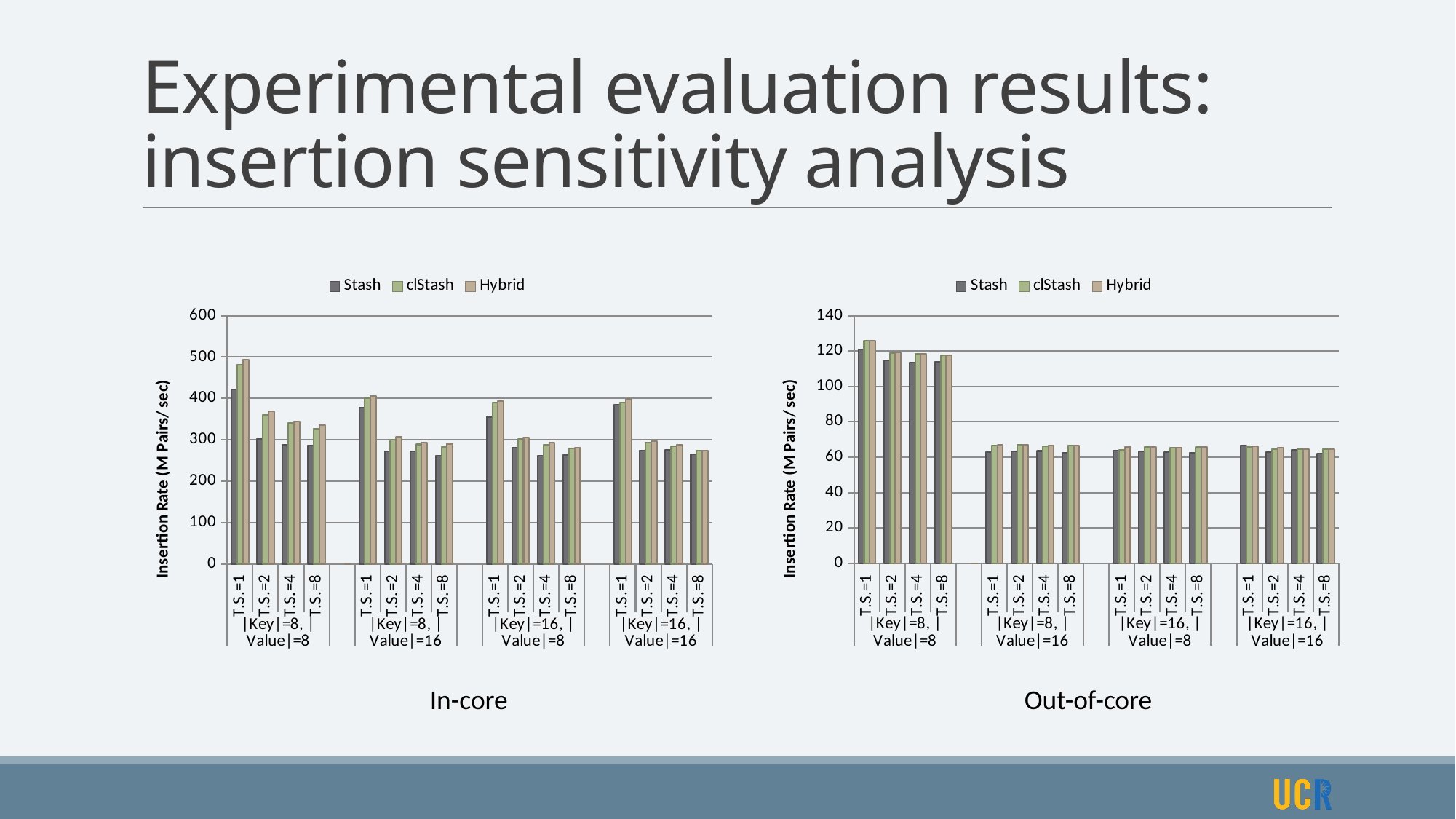
How many series does the legend of the Out-of-core chart list? 3 What kind of chart is the In-core chart? bar chart What is the y-axis label of the Out-of-core chart? Insertion Rate (M Pairs/ sec) In the Out-of-core chart, is the clStash value for |Key|=8, |Value|=8, T.S.=1 greater or less than 120? greater In the In-core chart, which is larger for Stash: |Key|=8, |Value|=8 at T.S.=1 or at T.S.=2? T.S.=1 In the In-core chart, do the Stash values rise or fall as T.S. increases from 1 to 8 within the |Key|=8, |Value|=8 group? fall In the Out-of-core chart, is the Stash value for |Key|=8, |Value|=16, T.S.=1 greater or less than 80? less In the In-core chart, how many T.S. categories are shown within the |Key|=8, |Value|=8 group? 4 In the In-core chart, which key/value group contains the tallest bars? |Key|=8, |Value|=8 In the Out-of-core chart, which is larger for Stash at T.S.=1: the |Key|=8, |Value|=8 group or the |Key|=8, |Value|=16 group? |Key|=8, |Value|=8 In the In-core chart, is the Hybrid value for |Key|=8, |Value|=8, T.S.=1 greater or less than 400? greater